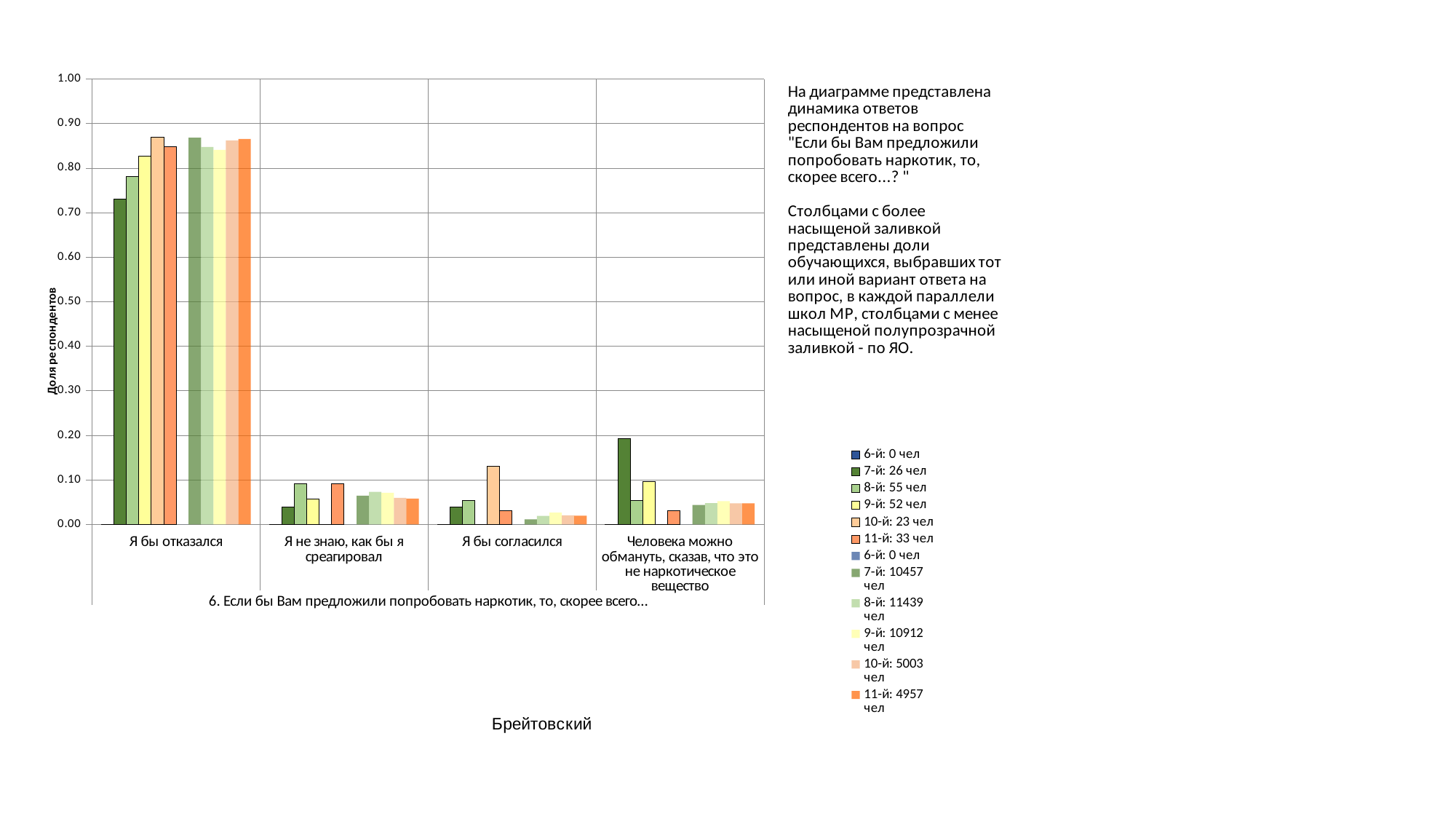
In the category "Я бы отказался", which is larger: the value for "7-й: 26 чел" or for "10-й: 23 чел"? 10-й: 23 чел What is the title shown below the chart? Брейтовский Is the value for the series "7-й: 26 чел" in the category "Человека можно обмануть, сказав, что это не наркотическое вещество" greater or less than 0.10? greater What is the label of the vertical axis of the chart? Доля респондентов Is the value for the series "10-й: 23 чел" in the category "Я бы отказался" greater or less than 0.80? greater How many answer categories are shown along the x axis of the chart? 4 Is the value for the series "7-й: 26 чел" in the category "Я бы отказался" greater or less than 0.60? greater How many series does the chart legend list? 12 Which answer category has the highest bars in the chart? Я бы отказался In the category "Человека можно обмануть, сказав, что это не наркотическое вещество", which is larger: the value for "7-й: 26 чел" or for "9-й: 52 чел"? 7-й: 26 чел What kind of chart is shown on the slide? bar chart